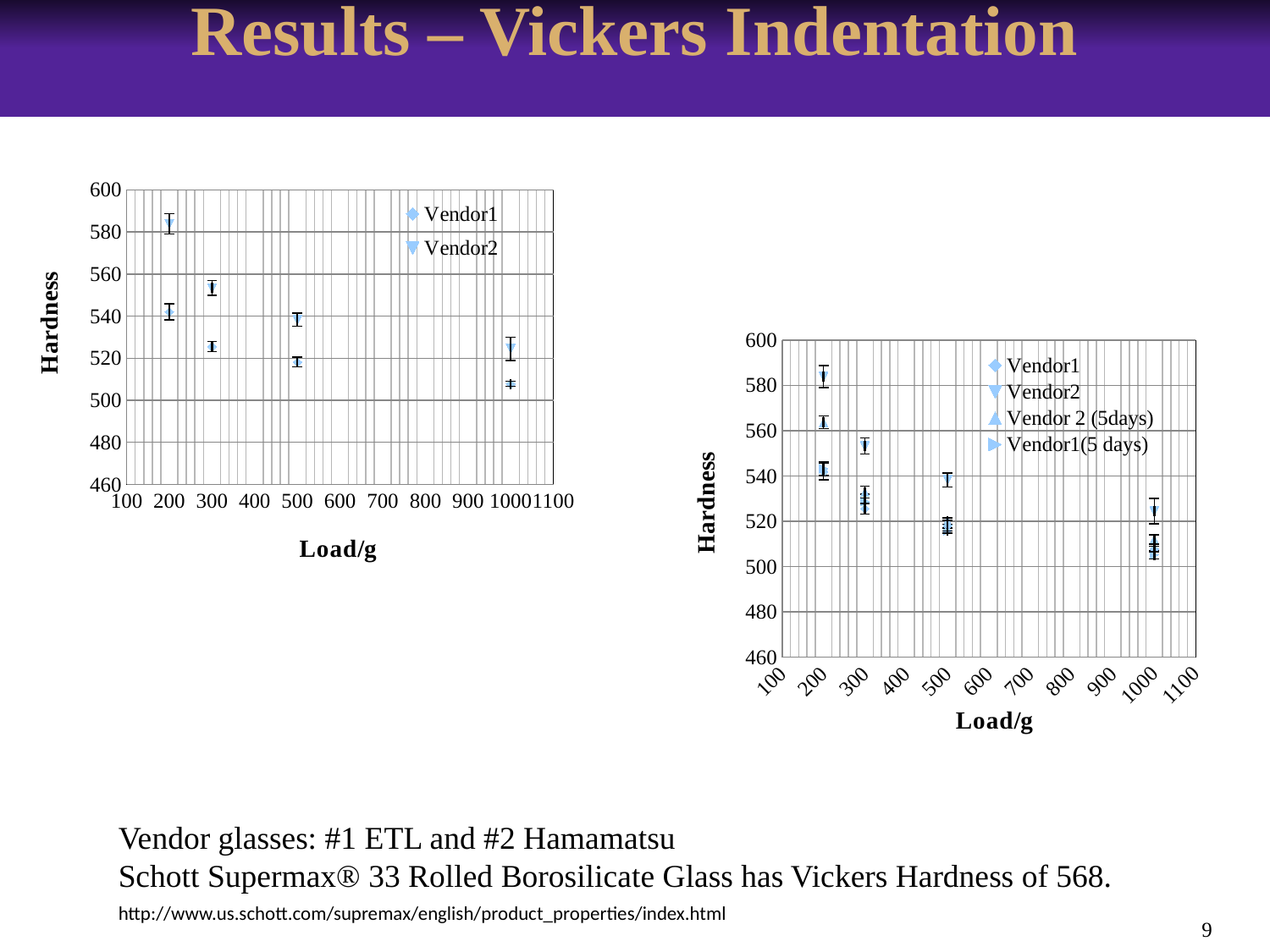
In the left chart, is the highest hardness value at a load of 200 greater or less than 580? greater In the left chart, is the lowest hardness value at a load of 1000 greater or less than 520? less In the right chart, is the lowest hardness value at a load of 1000 greater or less than 520? less In the left chart, what is the label of the x axis? Load/g In the left chart, do the hardness values rise or fall as the load increases? fall In the right chart, what is the label of the y axis? Hardness In the right chart, do the hardness values rise or fall as the load increases? fall How many series does the legend of the right chart list? 4 What kind of chart is the left chart? scatter chart In the left chart, at how many different load values are data points plotted? 4 How many series does the legend of the left chart list? 2 In the left chart, is the hardness at a load of 200 or at a load of 1000 higher? 200